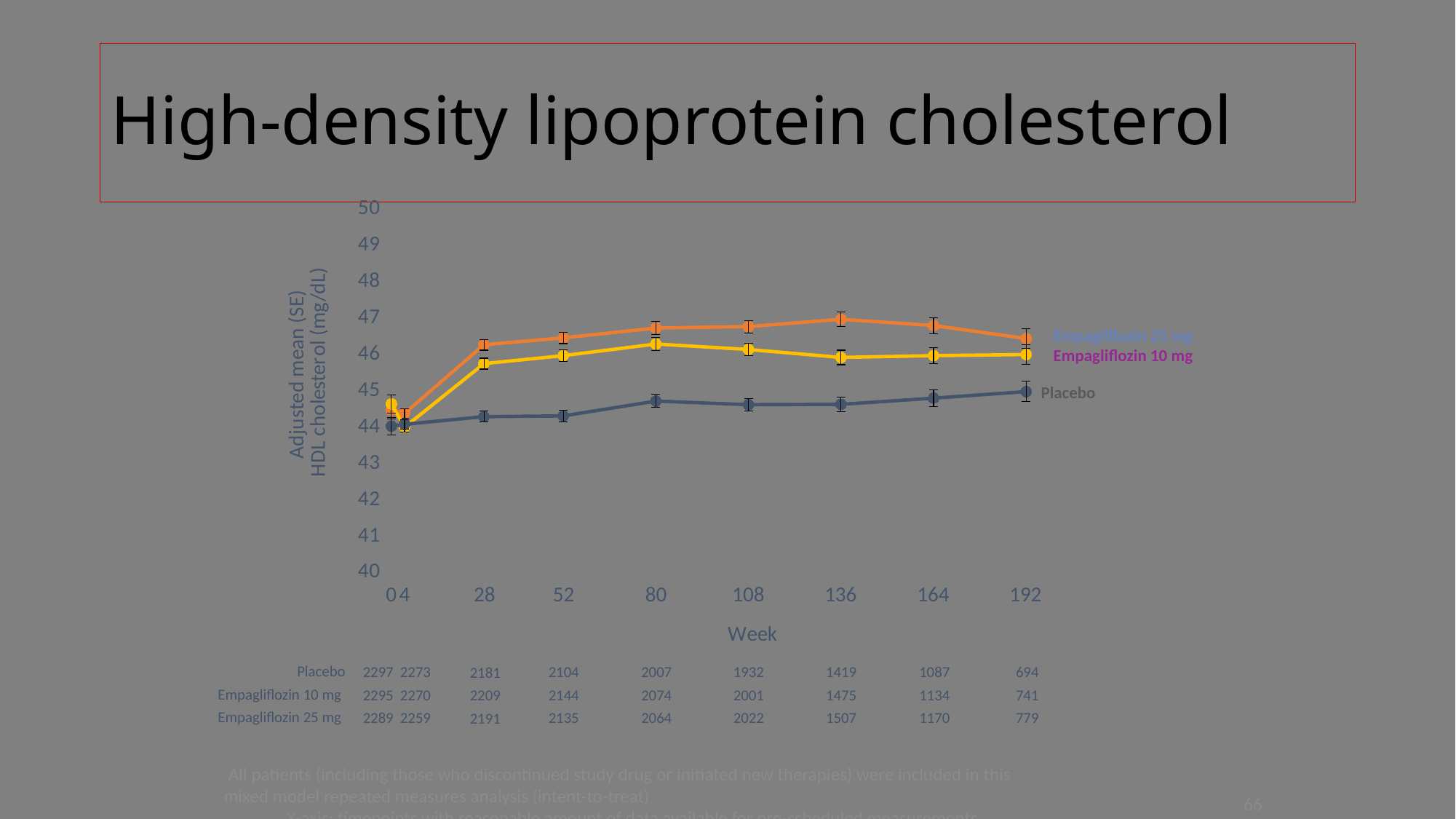
Which series has the lowest HDL cholesterol value at week 192? Placebo How many week time points are labelled on the x axis? 9 How many series are plotted on the chart? 3 Which series has the highest HDL cholesterol value at week 136? Empagliflozin 25 mg What kind of chart is shown on the slide? line chart At week 136, is the value for Empagliflozin 25 mg greater or less than 46? greater What is the y-axis label of the chart? Adjusted mean (SE) HDL cholesterol (mg/dL) At week 52, which is larger: the value for Empagliflozin 25 mg or the value for Placebo? Empagliflozin 25 mg At week 28, is the value for Empagliflozin 10 mg greater or less than 45? greater Does the Placebo line rise or fall from week 0 to week 192? rise What is the x-axis label of the chart? Week At week 80, is the value for Placebo greater or less than 45? less